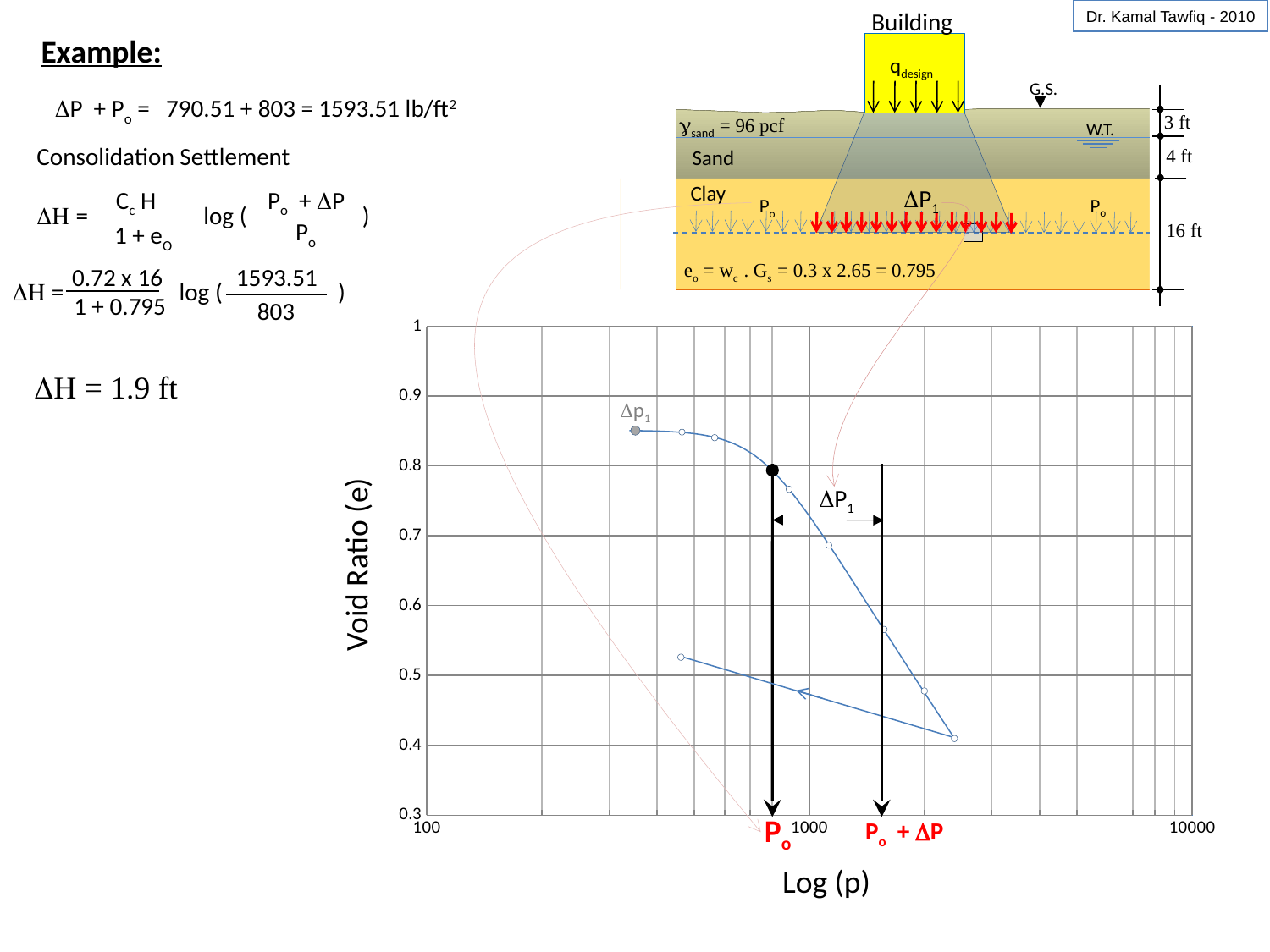
Is the void ratio at the point labelled Δp1 greater or less than 0.8? greater What is the label of the horizontal axis of the chart? Log (p) What is the lowest value shown on the vertical axis of the chart? 0.3 What kind of chart is shown on the slide? line chart What is the label of the vertical axis of the chart? Void Ratio (e) Is the void ratio at the point marked Po + ΔP greater or less than 0.6? less Is the lowest void ratio reached on the curve greater or less than 0.5? less Which has the larger void ratio on the curve, the point at Po or the point at Po + ΔP? Po Along the loading curve, does the void ratio rise or fall as p increases? fall